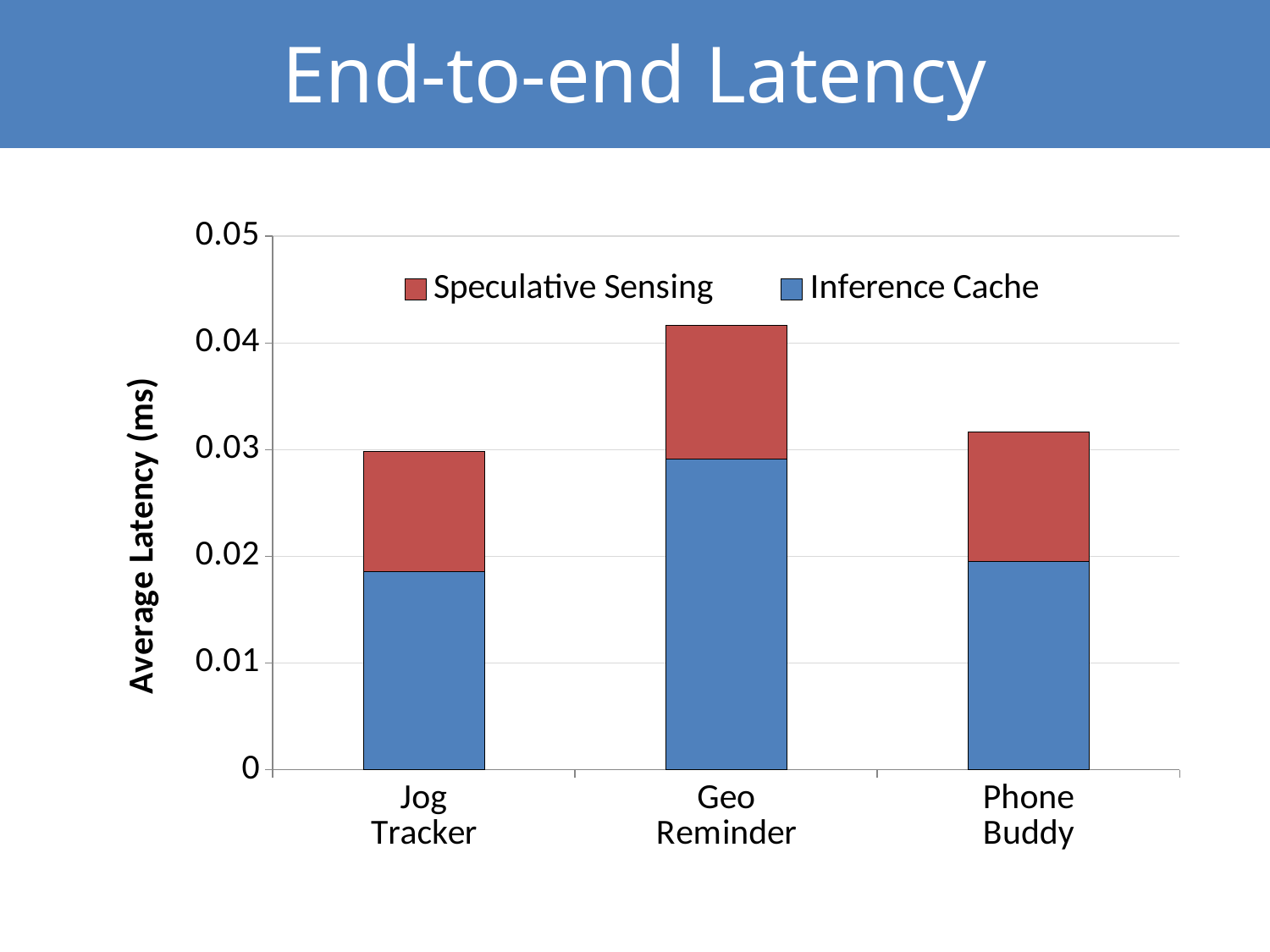
Which application has the highest total average latency? Geo Reminder Which application has the lowest total average latency? Jog Tracker Is the Inference Cache latency for Jog Tracker greater or less than 0.02? less How many applications (categories) are shown on the x axis? 3 Which application has the larger total average latency, Geo Reminder or Phone Buddy? Geo Reminder How many series does the legend list? 2 Which application has the highest Inference Cache latency? Geo Reminder Is the total average latency for Phone Buddy greater or less than 0.03? greater What is the label of the y axis? Average Latency (ms) Is the total average latency for Geo Reminder greater or less than 0.04? greater What kind of chart is shown on the slide? stacked bar chart